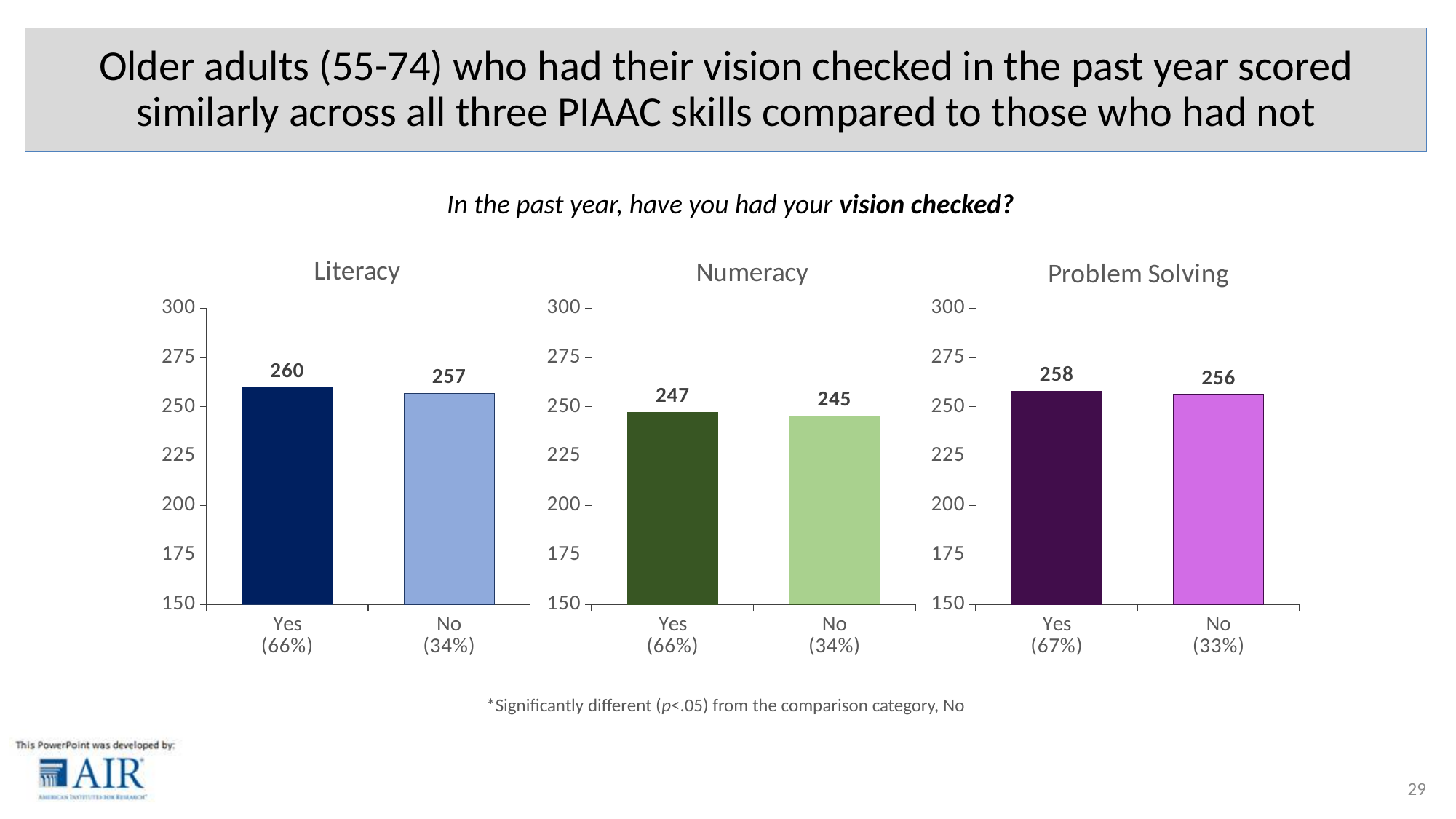
In the Problem Solving chart, what is the score for No (33%)? 256 In the Numeracy chart, what is the score for Yes (66%)? 247 In the Problem Solving chart, which category has the higher score, Yes or No? Yes What kind of chart is the Problem Solving chart? bar chart In the Numeracy chart, what is the score for No (34%)? 245 In the Numeracy chart, is the value for Yes greater or less than 250? less In the Literacy chart, what is the score for Yes (66%)? 260 In the Problem Solving chart, what is the score for Yes (67%)? 258 In the Numeracy chart, what is the difference between the Yes and No scores? 2 In the Literacy chart, what is the score for No (34%)? 257 In the Literacy chart, what is the difference between the Yes and No scores? 3 How many bars are shown in the Literacy chart? 2